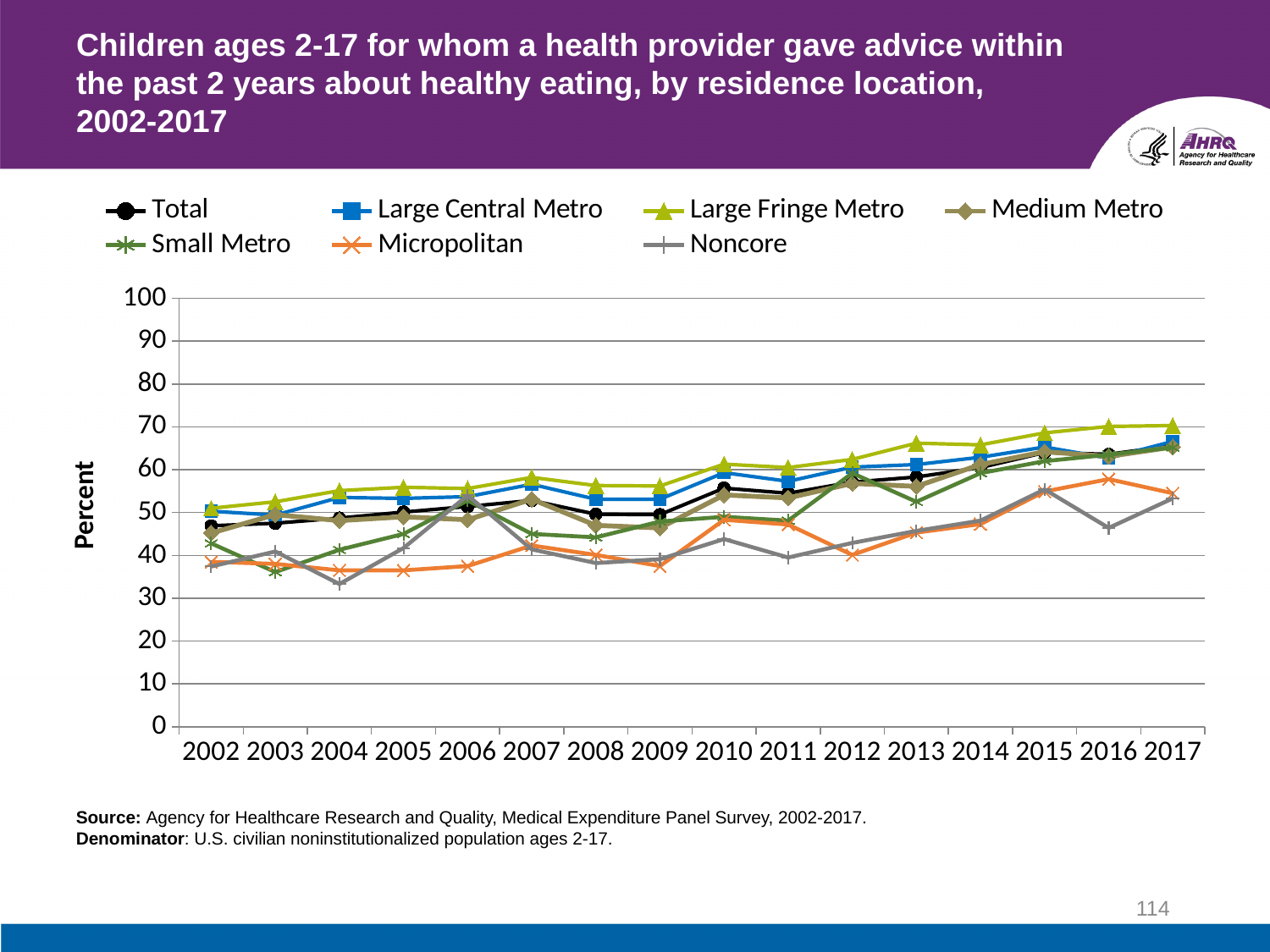
What is the label on the y axis? Percent How many years are plotted along the x axis? 16 Does the Total series generally rise or fall from 2002 to 2017? rise In 2017, which is larger: Large Fringe Metro or Micropolitan? Large Fringe Metro How many series does the legend list? 7 Is the value for Total in 2017 greater or less than 60? greater Is the value for Large Fringe Metro in 2017 greater or less than 60? greater Is the value for Noncore in 2004 greater or less than 40? less In 2004, which is larger: Large Central Metro or Noncore? Large Central Metro Which series has the lowest value in 2016? Noncore What kind of chart is shown on the slide? line chart Which series has the highest value in 2017? Large Fringe Metro